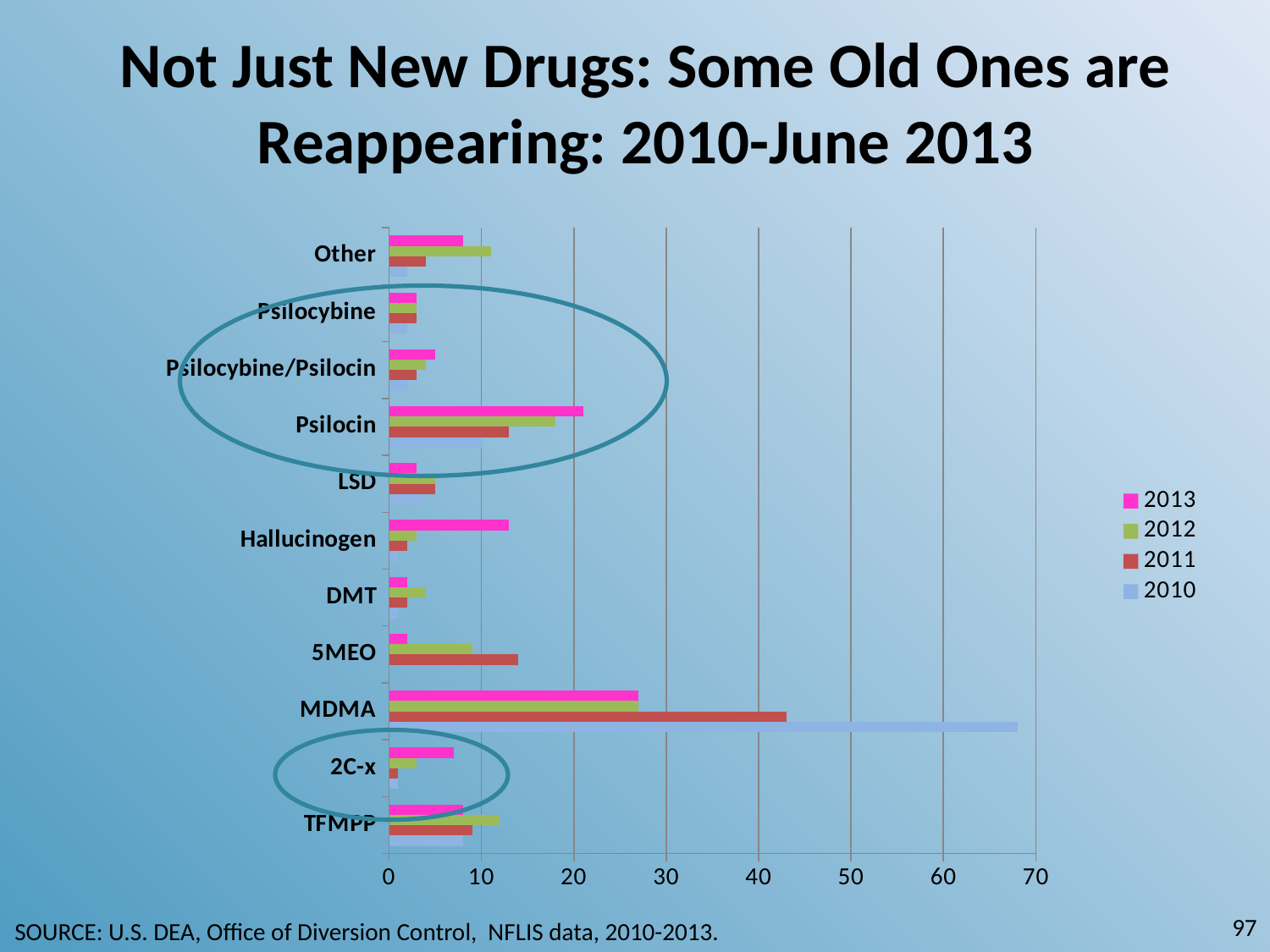
Which category has the highest value for 2010? MDMA What kind of chart is shown on the slide? Bar chart Is the 2011 value for 5MEO greater or less than 10? greater For 5MEO, which is larger: the 2011 value or the 2013 value? 2011 Is the 2010 value for MDMA greater or less than 60? greater Is the 2011 value for MDMA greater or less than 40? greater For MDMA, which is larger: the 2011 value or the 2013 value? 2011 How many drug categories are plotted on the chart? 11 How many series does the legend list? 4 Which category has the highest value for 2013? MDMA Which year is listed first in the legend? 2013